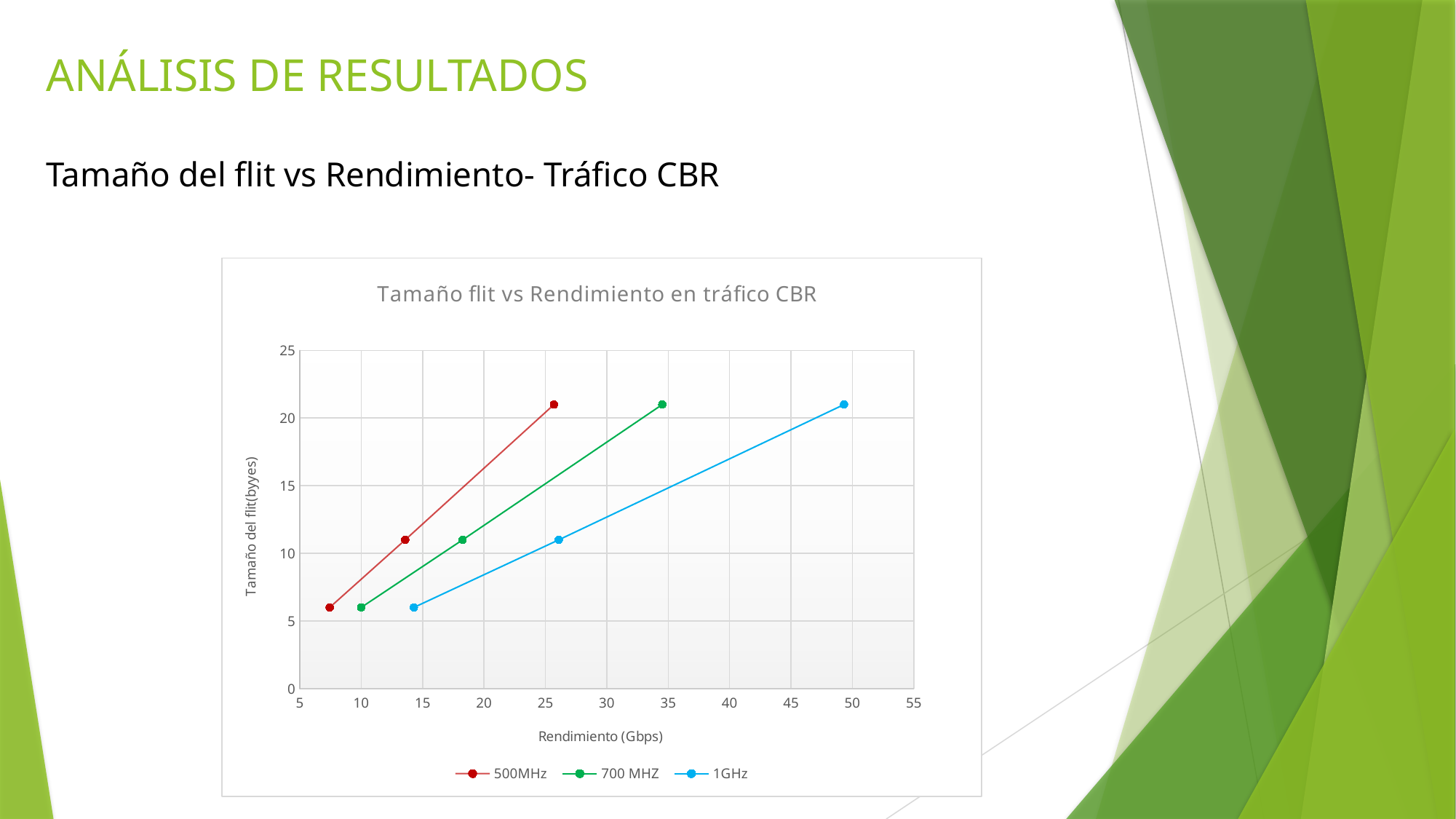
What is the label of the x axis? Rendimiento (Gbps) Which series reaches the lowest maximum Rendimiento (Gbps) value? 500MHz How many data points are plotted for the 1GHz series? 3 What kind of chart is shown on the slide? line chart Is the Rendimiento of the highest point of the 700 MHZ series greater or less than 30? greater Is the Rendimiento of the highest point of the 1GHz series greater or less than 45? greater Does the flit size rise or fall as Rendimiento increases along the x axis? rise Is the Rendimiento of the highest point of the 500MHz series greater or less than 30? less Which series reaches the highest Rendimiento (Gbps) value? 1GHz What is the title of the chart? Tamaño flit vs Rendimiento en tráfico CBR How many series does the legend list? 3